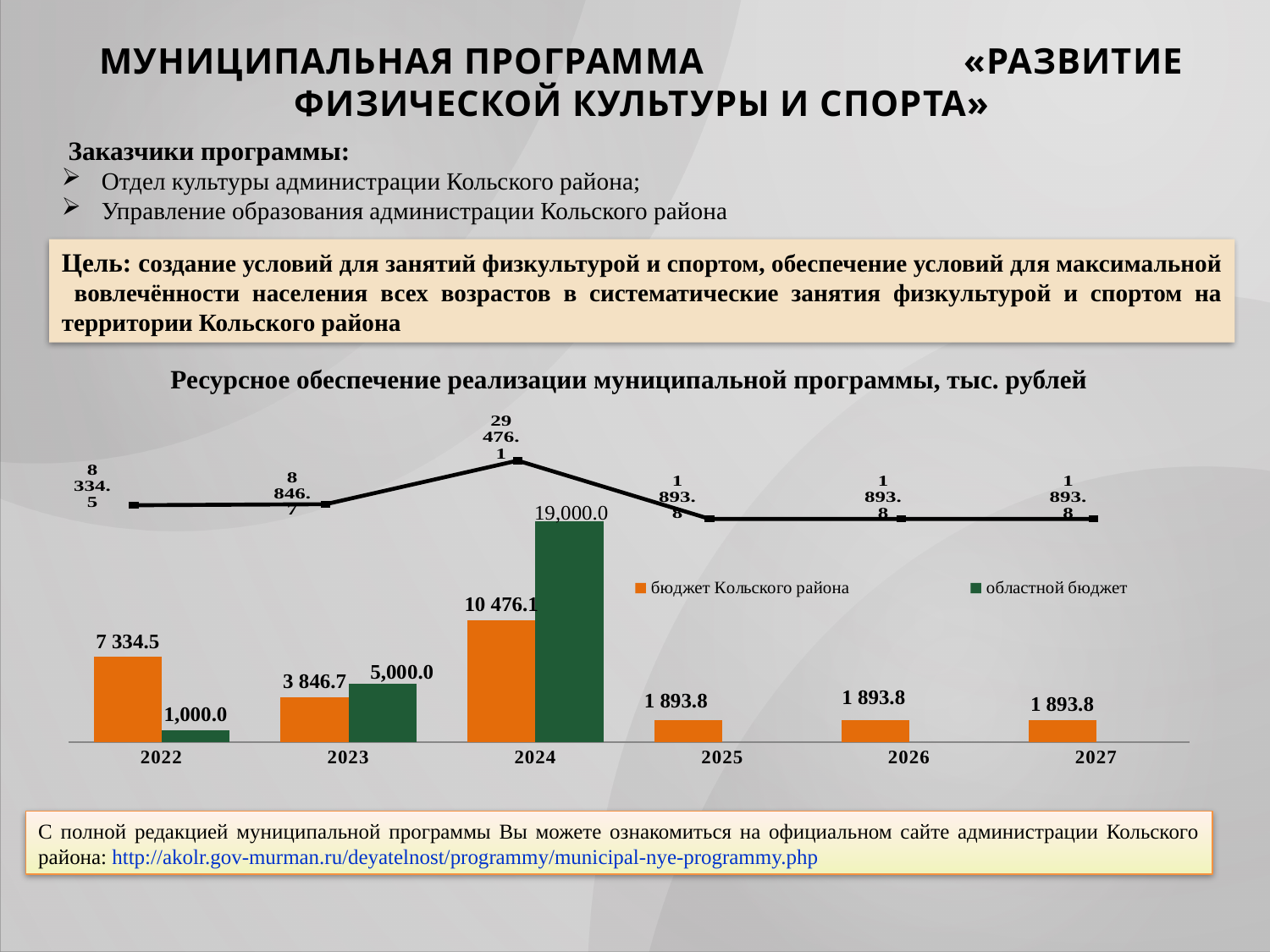
What kind of chart is used to show the budget values by year? Bar chart with a line What is the difference between the бюджет Кольского района values for 2024 and 2023? 6 629.4 What is the value of the бюджет Кольского района bar for 2022? 7 334.5 Which year has the lowest областной бюджет bar among the years where it is shown? 2022 What is the value of the областной бюджет bar for 2024? 19,000.0 What is the value of the областной бюджет bar for 2023? 5,000.0 What is the value of the бюджет Кольского района bar for 2026? 1 893.8 How many years are shown on the x axis of the chart? 6 How many series does the chart legend list? 2 Which year has the highest бюджет Кольского района bar? 2024 What is the combined total of бюджет Кольского района and областной бюджет for 2022? 8 334.5 Which is larger in 2023: бюджет Кольского района or областной бюджет? областной бюджет